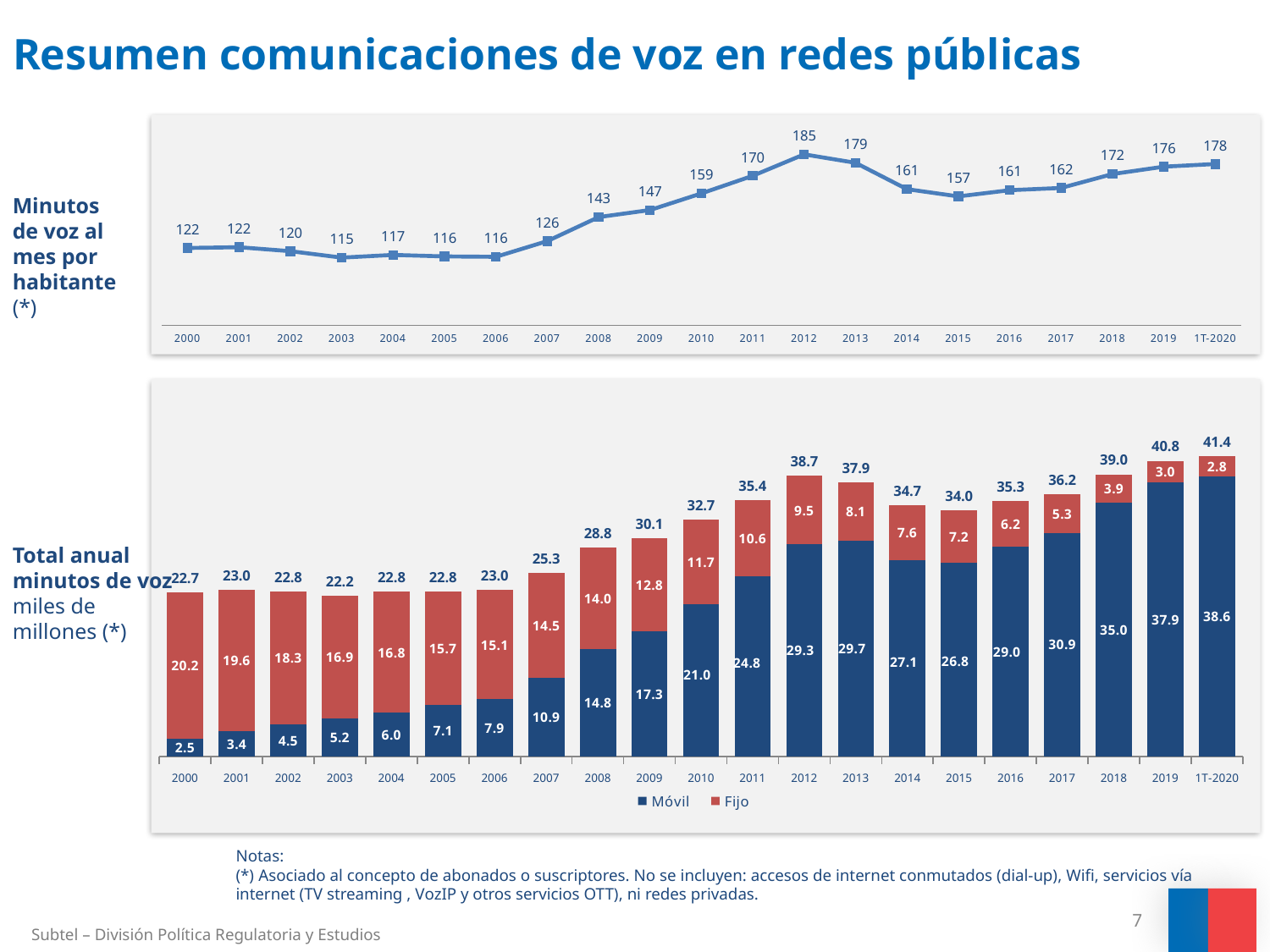
In the top chart (Minutos de voz al mes por habitante), which year has the lowest value? 2003 In the bottom chart (Total anual minutos de voz), what is the Fijo value for 2000? 20.2 In the top chart (Minutos de voz al mes por habitante), what is the difference between the values for 2012 and 2000? 63 In the bottom chart (Total anual minutos de voz), what is the total of the stacked bar for 1T-2020? 41.4 In the top chart (Minutos de voz al mes por habitante), what is the value for 2012? 185 In the top chart (Minutos de voz al mes por habitante), which year has the highest value? 2012 In the bottom chart (Total anual minutos de voz), does the Fijo value rise or fall from 2000 to 1T-2020? Fall In the bottom chart (Total anual minutos de voz), which is larger in 2008: Móvil or Fijo? Móvil How many categories are shown on the x axis of the bottom chart (Total anual minutos de voz)? 21 What kind of chart is the top chart (Minutos de voz al mes por habitante)? Line chart In the bottom chart (Total anual minutos de voz), what is the Móvil value for 2019? 37.9 How many series does the legend of the bottom chart (Total anual minutos de voz) list? 2